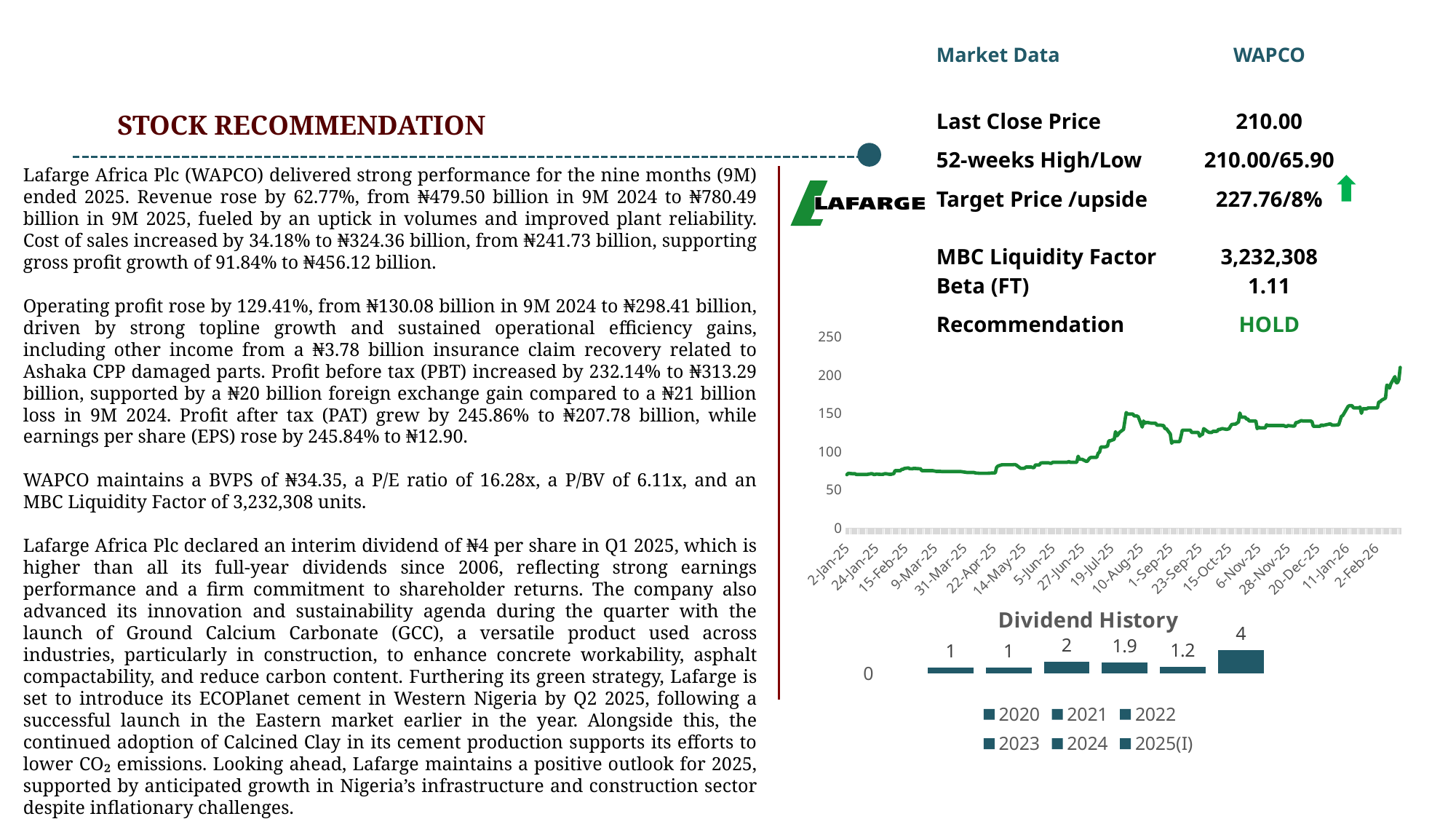
How many series does the legend of the Dividend History chart list? 6 In the price line chart, do values generally rise or fall from 2-Jan-25 to 2-Feb-26? rise In the price line chart, is the value at 2-Jan-25 greater or less than 100? less In the Dividend History chart, which year has the highest dividend? 2025(I) In the Dividend History chart, which is larger, the dividend for 2023 or the dividend for 2024? 2023 In the price line chart, is the value at the end of the series (after 2-Feb-26) greater or less than 150? greater In the Dividend History chart, what is the dividend value for 2024? 1.2 In the Dividend History chart, what is the dividend value for 2025(I)? 4 In the Dividend History chart, what is the difference between the 2025(I) dividend and the 2022 dividend? 2 In the Dividend History chart, what is the dividend value for 2023? 1.9 What kind of chart is the price chart above the Dividend History chart? line chart What kind of chart is the Dividend History chart? bar chart